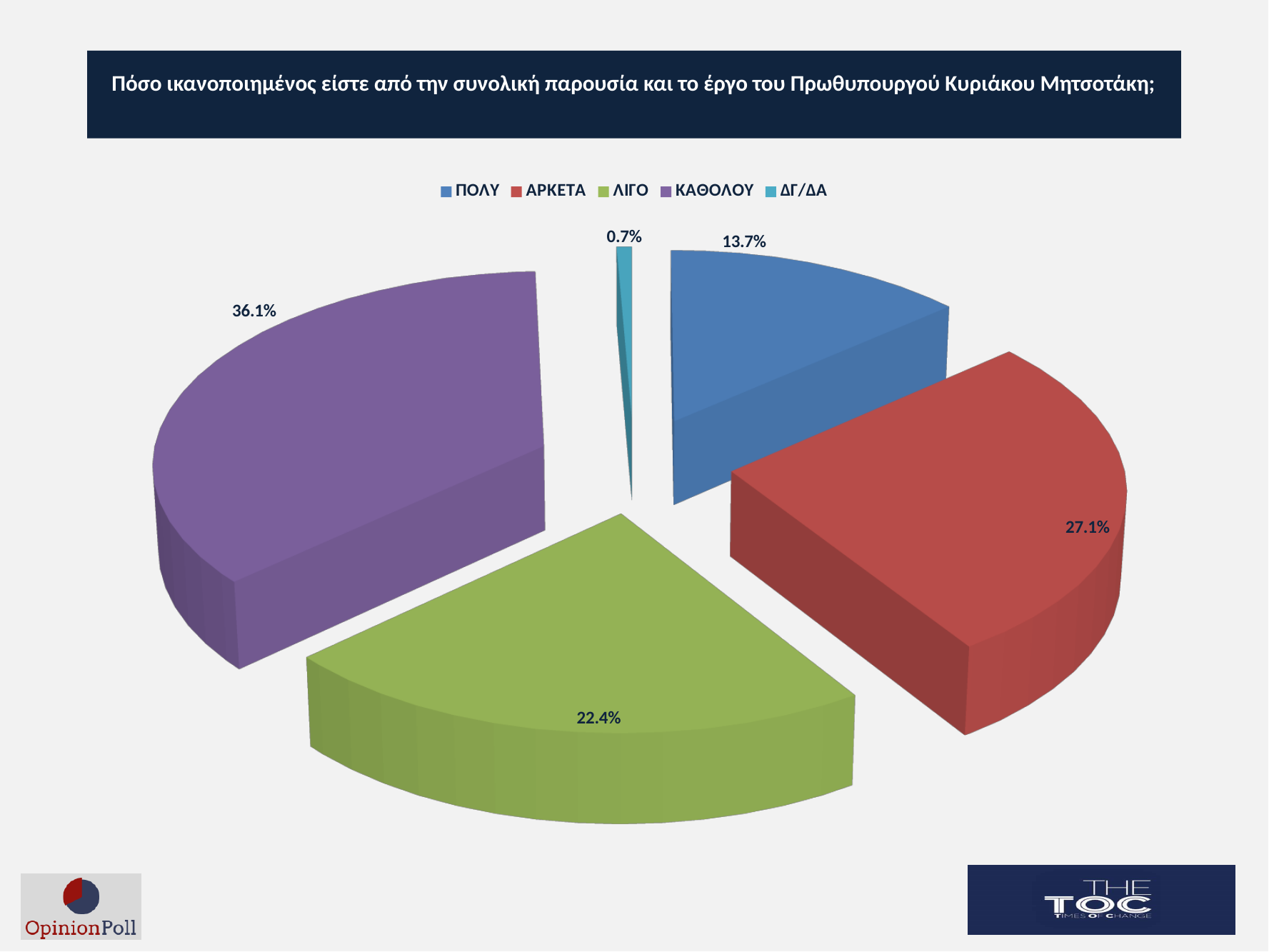
What colour is the slice for ΛΙΓΟ? Green Which is larger, the share for ΑΡΚΕΤΑ or the share for ΛΙΓΟ? ΑΡΚΕΤΑ What percentage is shown for ΚΑΘΟΛΟΥ? 36.1% Which category has the largest share of the pie? ΚΑΘΟΛΟΥ What percentage is shown for ΠΟΛΥ? 13.7% Which category has the smallest share of the pie? ΔΓ/ΔΑ What is the difference in percentage points between ΚΑΘΟΛΟΥ and ΑΡΚΕΤΑ? 9.0 What percentage is shown for ΛΙΓΟ? 22.4% What percentage is shown for ΑΡΚΕΤΑ? 27.1% How many categories does the legend list? 5 What kind of chart is shown on the slide? Pie chart What percentage is shown for ΔΓ/ΔΑ? 0.7%